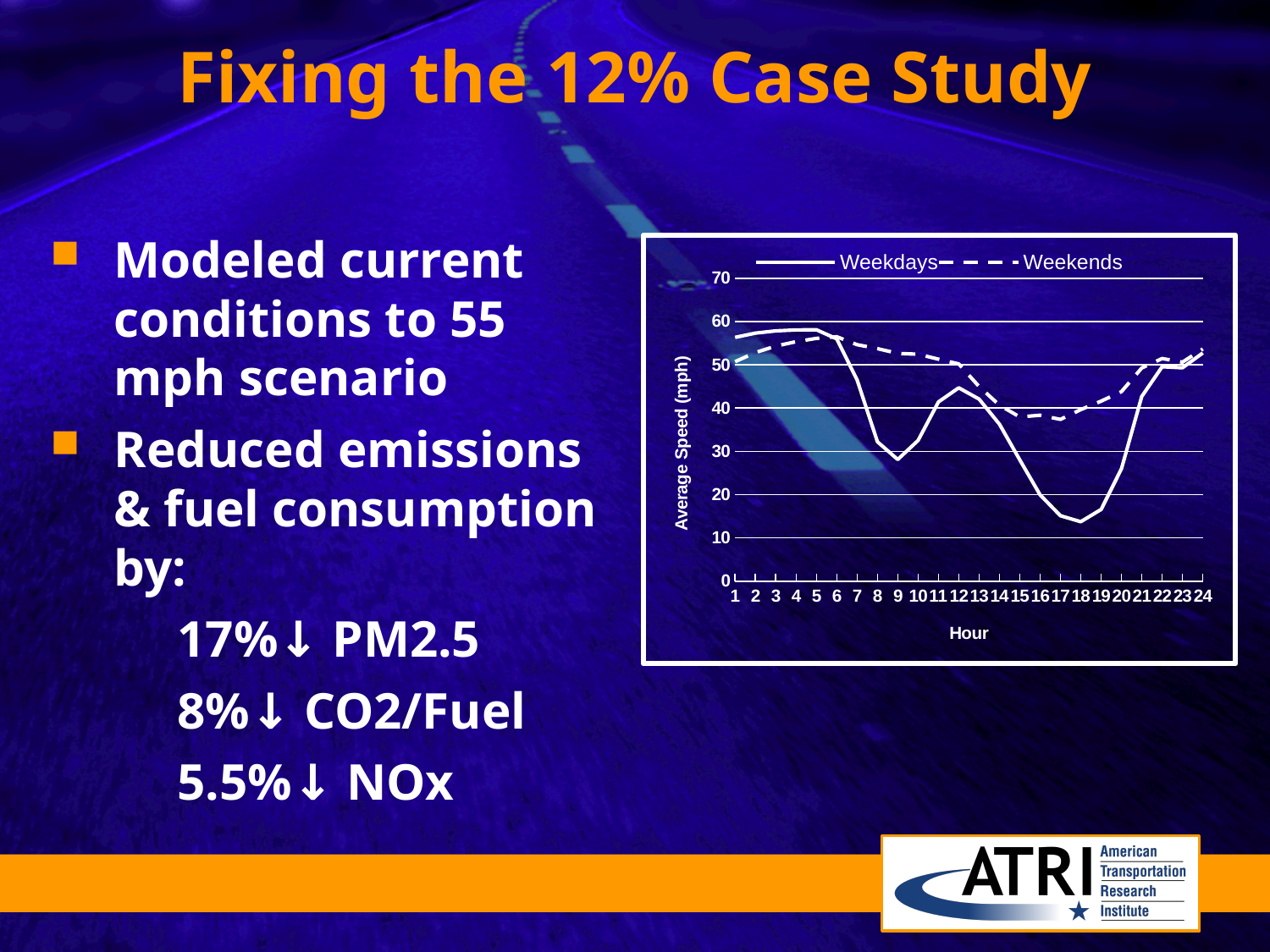
Is the Weekends value at hour 17 greater or less than 40? less What are the two series named in the chart's legend? Weekdays and Weekends How many series does the chart's legend list? 2 At hour 18, which series has the higher average speed, Weekdays or Weekends? Weekends What kind of chart is shown on the slide? line chart What is the title of the chart's vertical axis? Average Speed (mph) Is the Weekdays value at hour 18 greater or less than 20? less Does the Weekdays series rise or fall between hour 18 and hour 24? rise At which hour does the Weekdays series reach its lowest average speed? 18 Is the Weekdays value at hour 5 greater or less than 50? greater How many hours are plotted along the x axis of the chart? 24